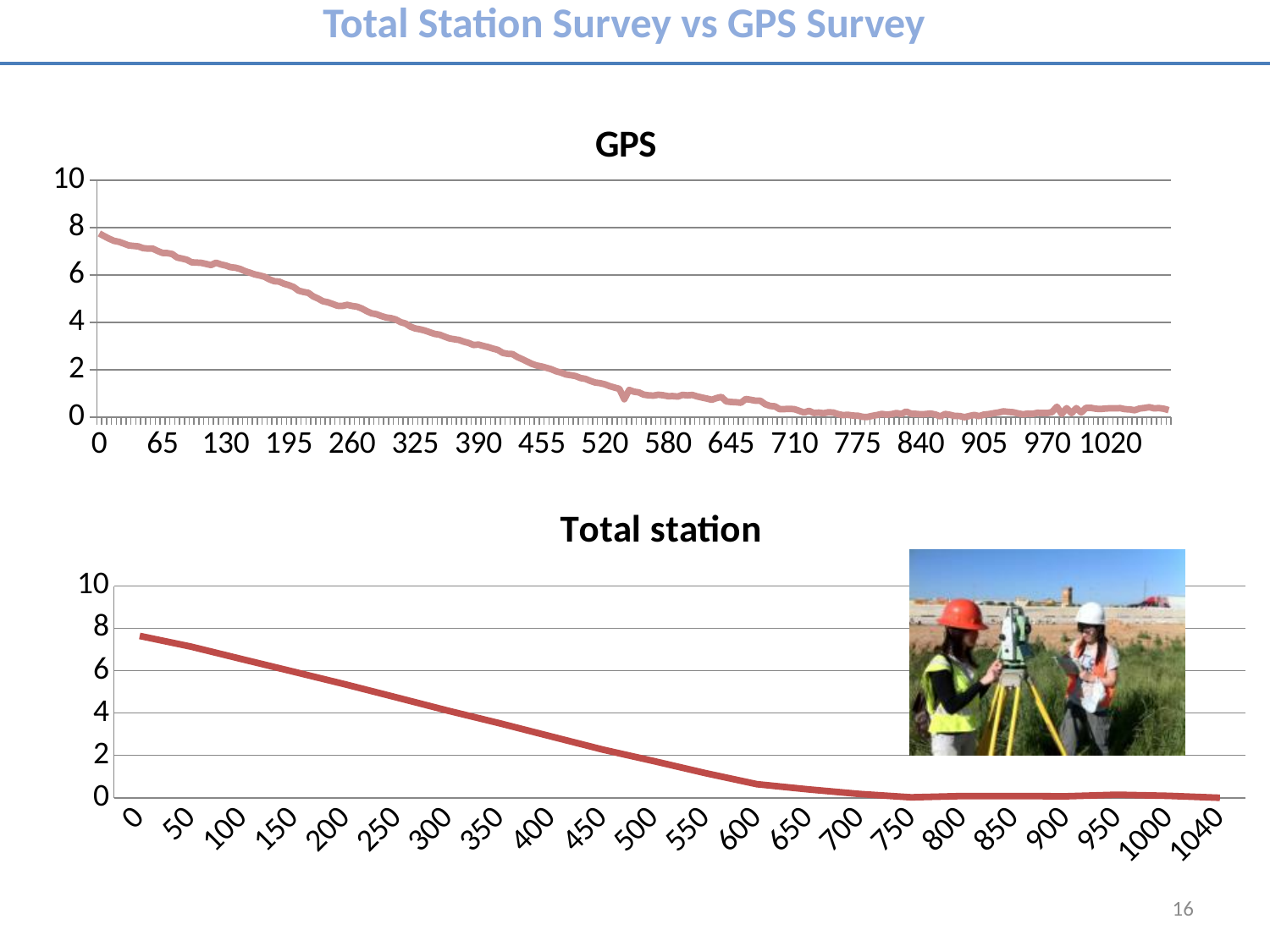
In the GPS chart, which is larger: the value at x = 0 or the value at x = 1020? x = 0 In the GPS chart, is the value at x = 390 greater or less than 4? less In the GPS chart, is the value at x = 520 greater or less than 2? less What kind of chart is the GPS chart? line chart In the Total station chart, is the value at x = 600 greater or less than 2? less In the GPS chart, do the values generally rise or fall as the x axis increases? fall In the Total station chart, do the values rise or fall from 0 to 600 on the x axis? fall What is the title of the slide? Total Station Survey vs GPS Survey What kind of chart is the Total station chart? line chart How many x-axis labels are shown on the Total station chart? 22